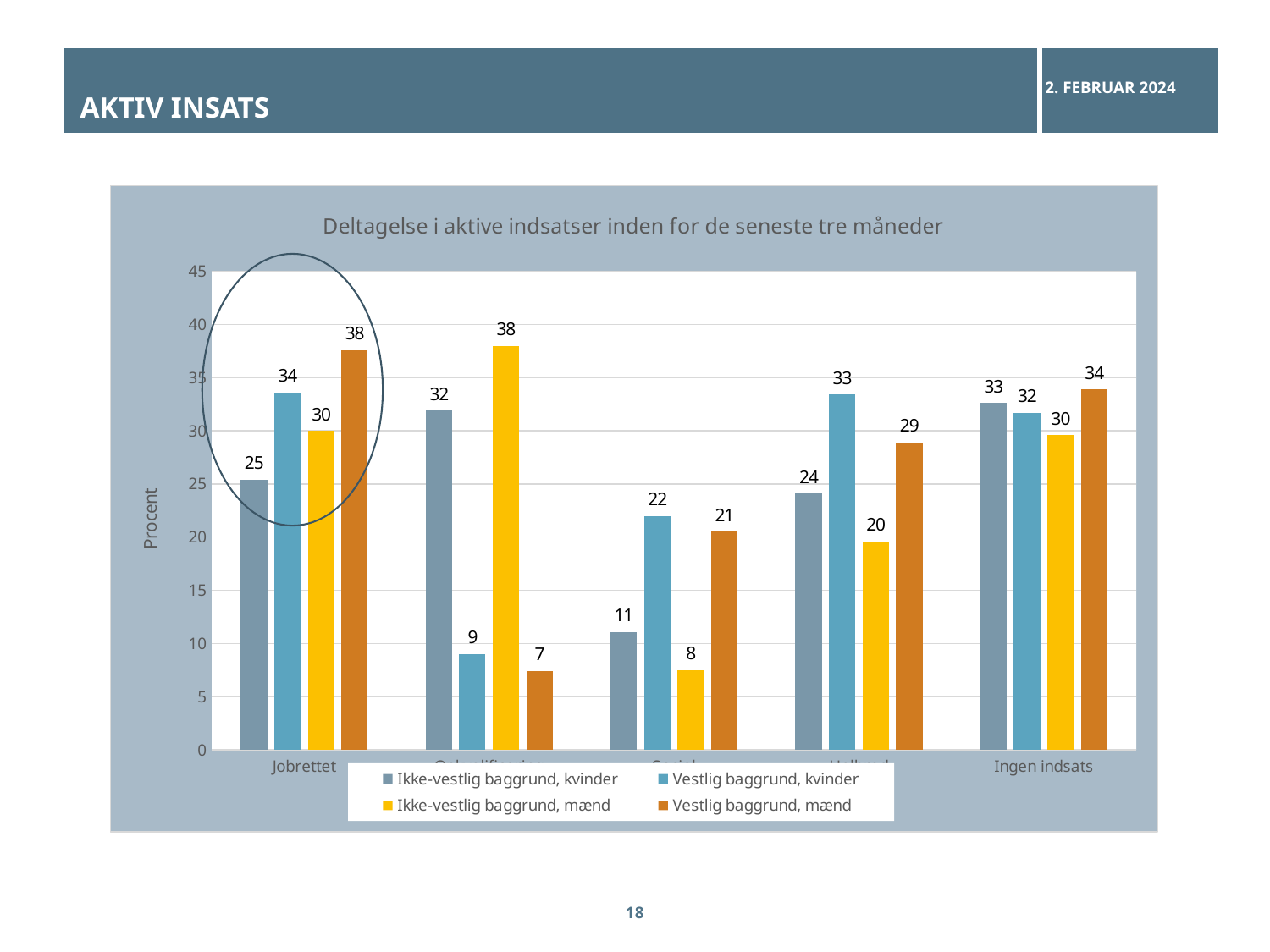
What is the value for Ikke-vestlig baggrund, mænd in the Ingen indsats category? 30 What is the title of the chart? Deltagelse i aktive indsatser inden for de seneste tre måneder Is the value for Vestlig baggrund, kvinder in the Jobrettet category greater or less than 30? greater Which series has the lowest value in the Jobrettet category? Ikke-vestlig baggrund, kvinder In the Ingen indsats category, which is larger: Ikke-vestlig baggrund, kvinder or Ikke-vestlig baggrund, mænd? Ikke-vestlig baggrund, kvinder What is the value for Vestlig baggrund, mænd in the Jobrettet category? 38 How many series does the legend list? 4 Which series has the highest value in the Jobrettet category? Vestlig baggrund, mænd What kind of chart is shown on the slide? Bar chart What is the difference between Vestlig baggrund, mænd and Ikke-vestlig baggrund, kvinder in the Jobrettet category? 13 What is the value for Ikke-vestlig baggrund, kvinder in the Jobrettet category? 25 What is the value for Vestlig baggrund, kvinder in the Ingen indsats category? 32